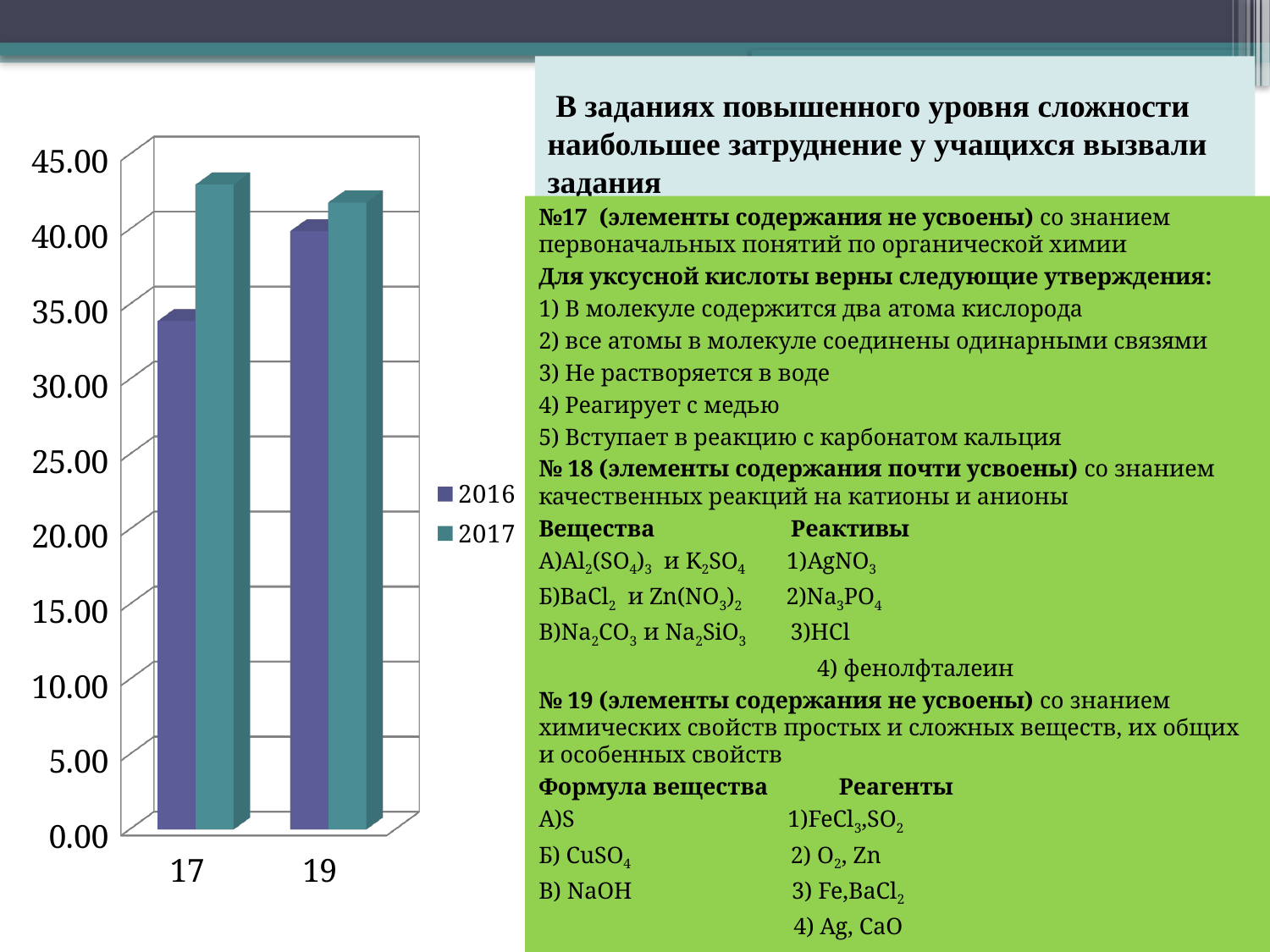
Is the 2016 value for category 17 greater or less than 30? greater Is the 2016 value for category 19 greater or less than 35? greater Does the 2016 series rise or fall from category 17 to category 19? rise Is the 2016 value for category 17 greater or less than 35? less Which series are listed in the chart legend? 2016 and 2017 Which bar is the tallest in the chart? 2017 for category 17 What kind of chart is shown on the slide? bar chart How many categories are shown on the x axis of the chart? 2 Which categories are shown on the x axis of the chart? 17 and 19 For category 17, which series has the larger value, 2016 or 2017? 2017 How many series does the chart legend list? 2